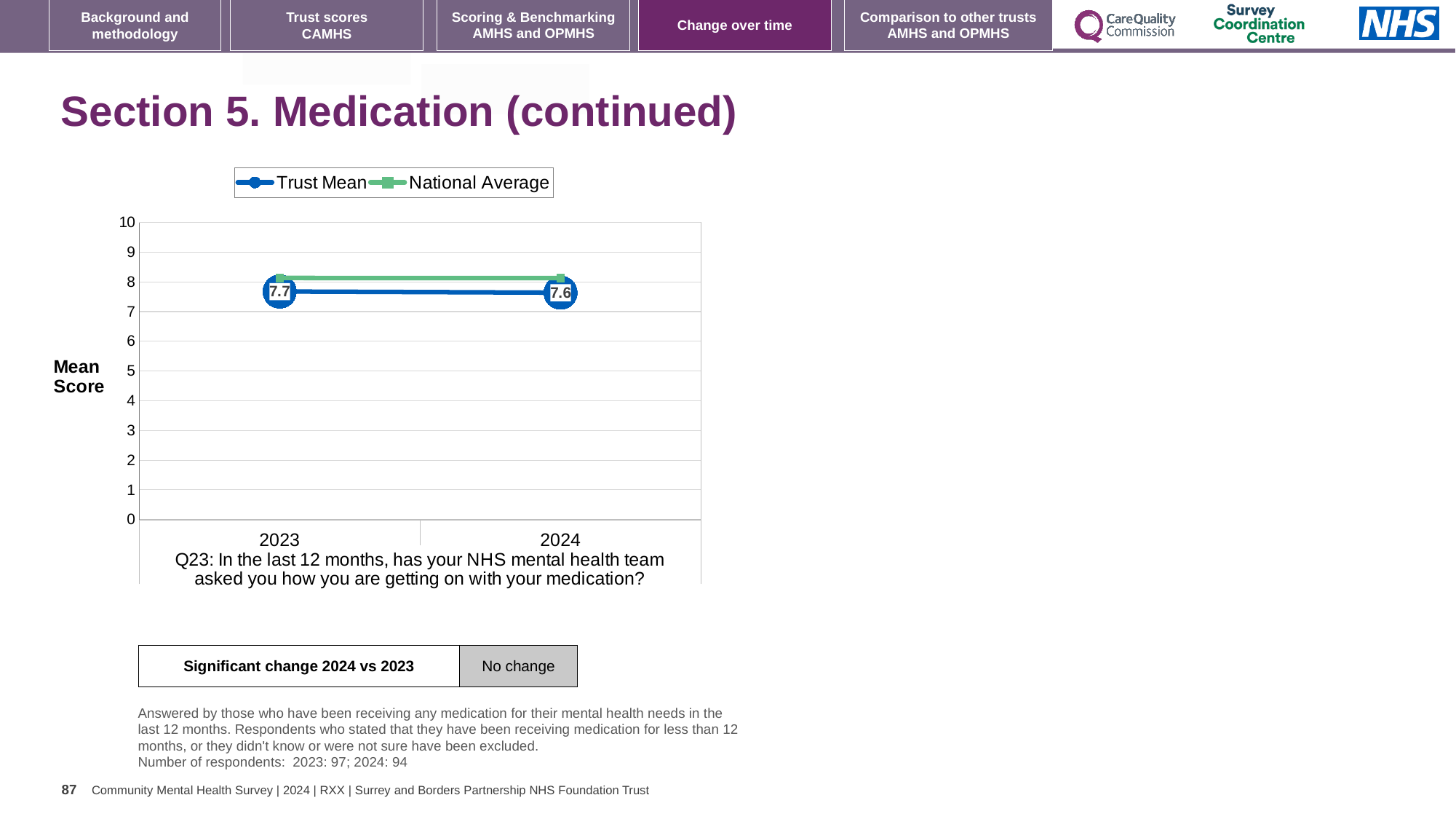
What is the Trust Mean score for 2024? 7.6 Does the Trust Mean rise or fall from 2023 to 2024? fall What is the Trust Mean score for 2023? 7.7 In which year is the Trust Mean score lower? 2024 What kind of chart is shown on the slide? line chart What is the difference between the Trust Mean scores for 2023 and 2024? 0.1 In 2023, which is higher: the Trust Mean or the National Average? National Average Is the National Average value for 2024 greater or less than 7? greater Is the National Average value for 2023 greater or less than 9? less How many series does the legend list? 2 How many years are plotted on the x axis? 2 In which year is the Trust Mean score higher? 2023